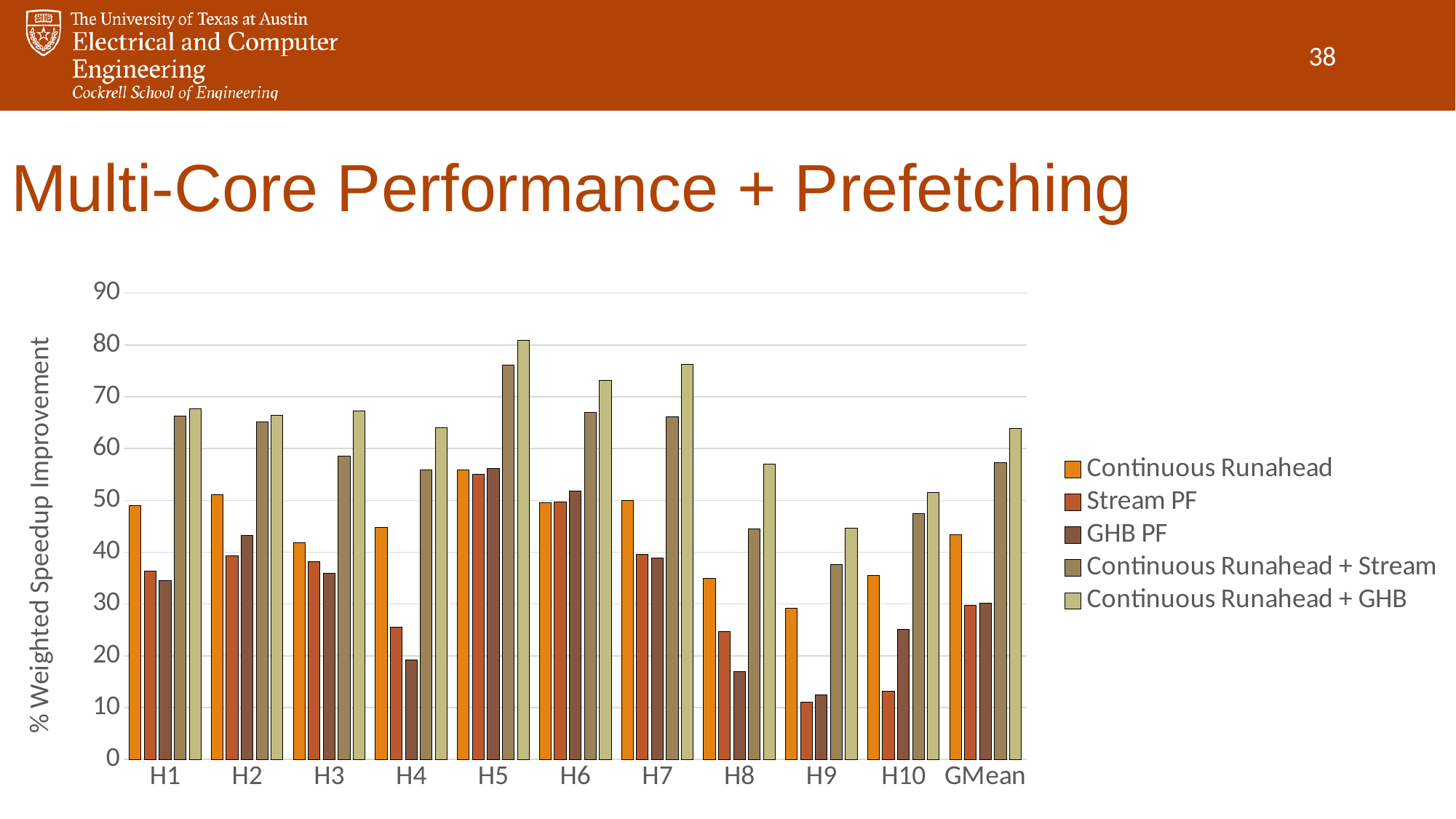
Is the Continuous Runahead + GHB value for H5 greater or less than 80? greater Which category has the highest Continuous Runahead + GHB bar? H5 Which category has the lowest Stream PF bar? H9 Is the Continuous Runahead value for GMean greater or less than 40? greater For H8, which is larger: Continuous Runahead or Continuous Runahead + Stream? Continuous Runahead + Stream What is the label of the y axis? % Weighted Speedup Improvement Which category has the highest Continuous Runahead bar? H5 What kind of chart is shown on the slide? Bar chart Is the GHB PF value for H4 greater or less than 20? less How many categories are shown along the x axis? 11 For H10, which is larger: Stream PF or GHB PF? GHB PF How many series does the legend list? 5